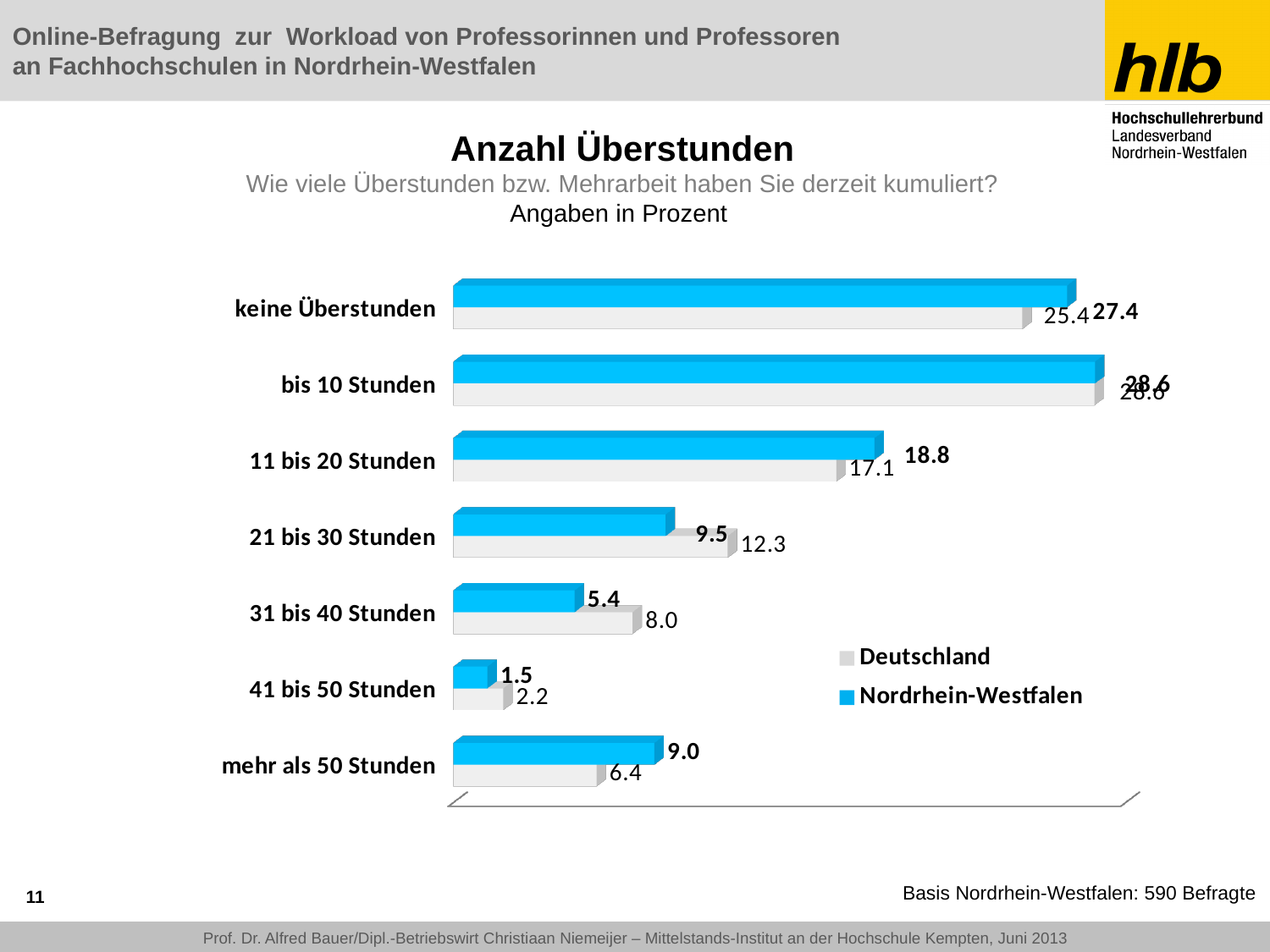
What is the value for Deutschland in the category '31 bis 40 Stunden'? 8.0 How many series does the legend list? 2 In the category 'mehr als 50 Stunden', which series has the larger value, Deutschland or Nordrhein-Westfalen? Nordrhein-Westfalen Which category has the lowest value for Nordrhein-Westfalen? 41 bis 50 Stunden What is the value for Nordrhein-Westfalen in the category 'mehr als 50 Stunden'? 9.0 How many categories are shown on the chart? 7 What kind of chart is shown on the slide? bar chart What is the value for Deutschland in the category '11 bis 20 Stunden'? 17.1 Which category has the lowest value for Deutschland? 41 bis 50 Stunden What is the value for Nordrhein-Westfalen in the category 'keine Überstunden'? 27.4 What is the difference between the Deutschland and Nordrhein-Westfalen values for '21 bis 30 Stunden'? 2.8 Which series is shown in blue according to the legend? Nordrhein-Westfalen